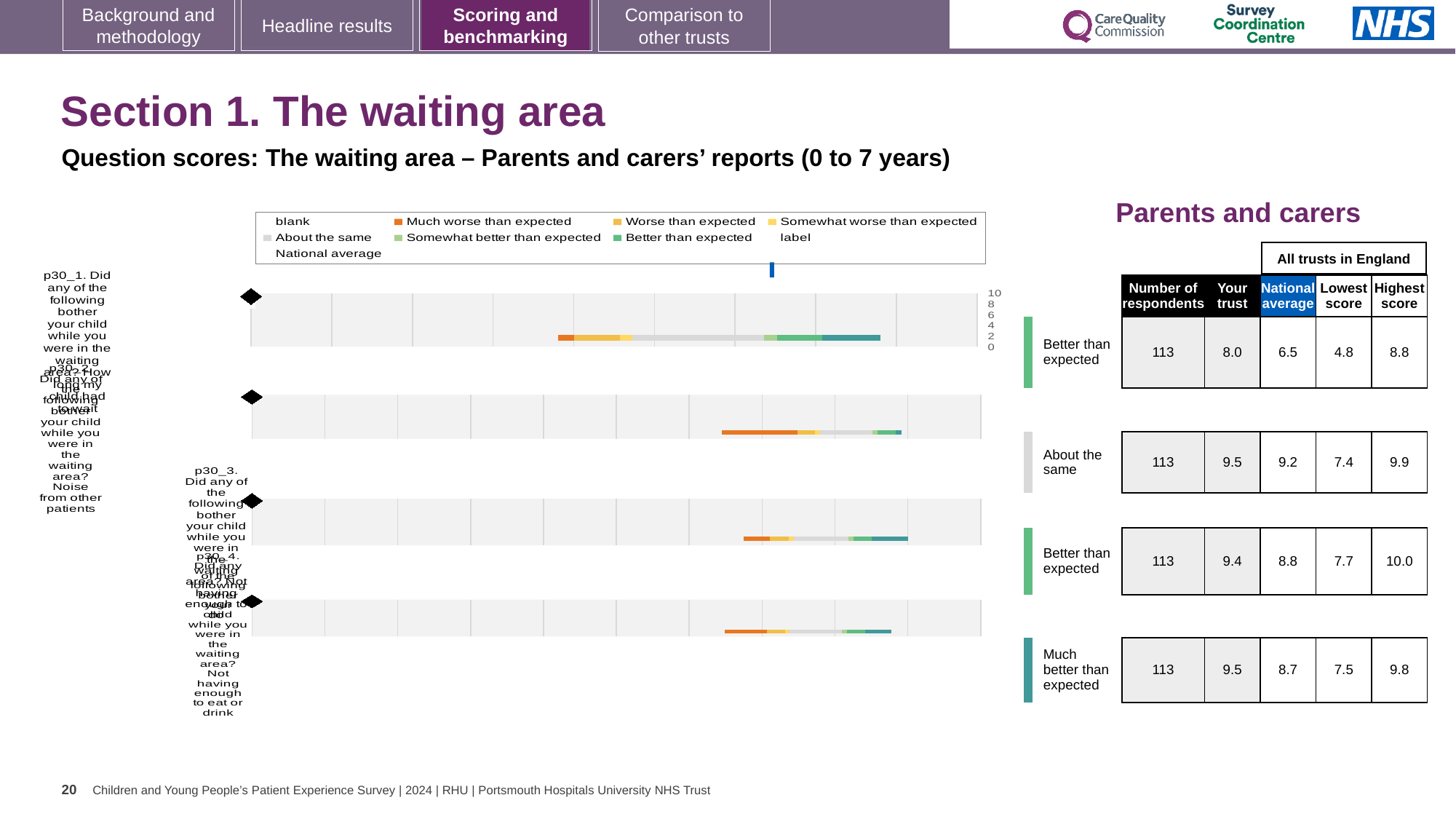
In the chart legend, what colour represents 'About the same'? grey In the table on the right, what is the 'Highest score' in the fourth row? 9.8 What kind of chart is shown on the left of the slide? bar chart In the table on the right, what is the 'Lowest score' in the second row? 7.4 In the table on the right, how many respondents are shown in each row? 113 How many questions (bars) are plotted in the chart on the left? 4 In the chart legend, what colour represents 'Much worse than expected'? orange In the table on the right, what is the 'Your trust' score in the first row? 8.0 In the table on the right, what is the difference between 'Your trust' and 'National average' in the first row? 1.5 In the table on the right, in the fourth row, which is larger: 'Your trust' or 'National average'? Your trust In the table on the right, which row has the highest 'Highest score' value? the third row (10.0) In the table on the right, what is the 'National average' in the second row? 9.2